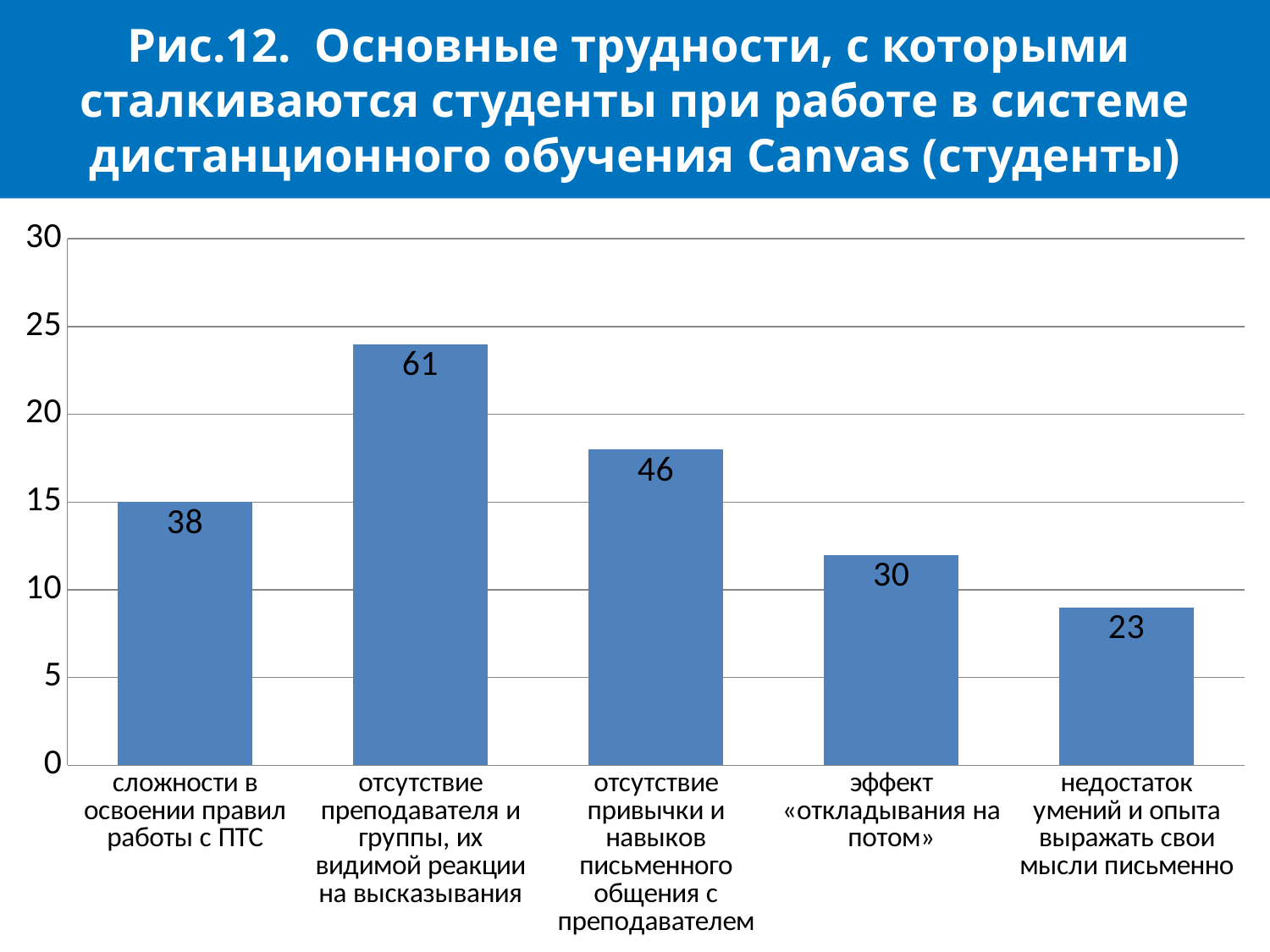
Which category has the lowest value? недостаток умений и опыта выражать свои мысли письменно What value is shown for «отсутствие привычки и навыков письменного общения с преподавателем»? 46 What value is shown for «эффект «откладывания на потом»»? 30 What is the figure number given in the slide title? Рис.12 What value is shown for the category «сложности в освоении правил работы с ПТС»? 38 What value is shown for «отсутствие преподавателя и группы, их видимой реакции на высказывания»? 61 What value is shown for «недостаток умений и опыта выражать свои мысли письменно»? 23 What is the difference between the values for «отсутствие преподавателя и группы, их видимой реакции на высказывания» and «недостаток умений и опыта выражать свои мысли письменно»? 38 What kind of chart is shown on the slide? bar chart Which is larger: the value for «сложности в освоении правил работы с ПТС» or for «эффект «откладывания на потом»»? сложности в освоении правил работы с ПТС How many categories are shown on the chart? 5 Which category has the highest value? отсутствие преподавателя и группы, их видимой реакции на высказывания